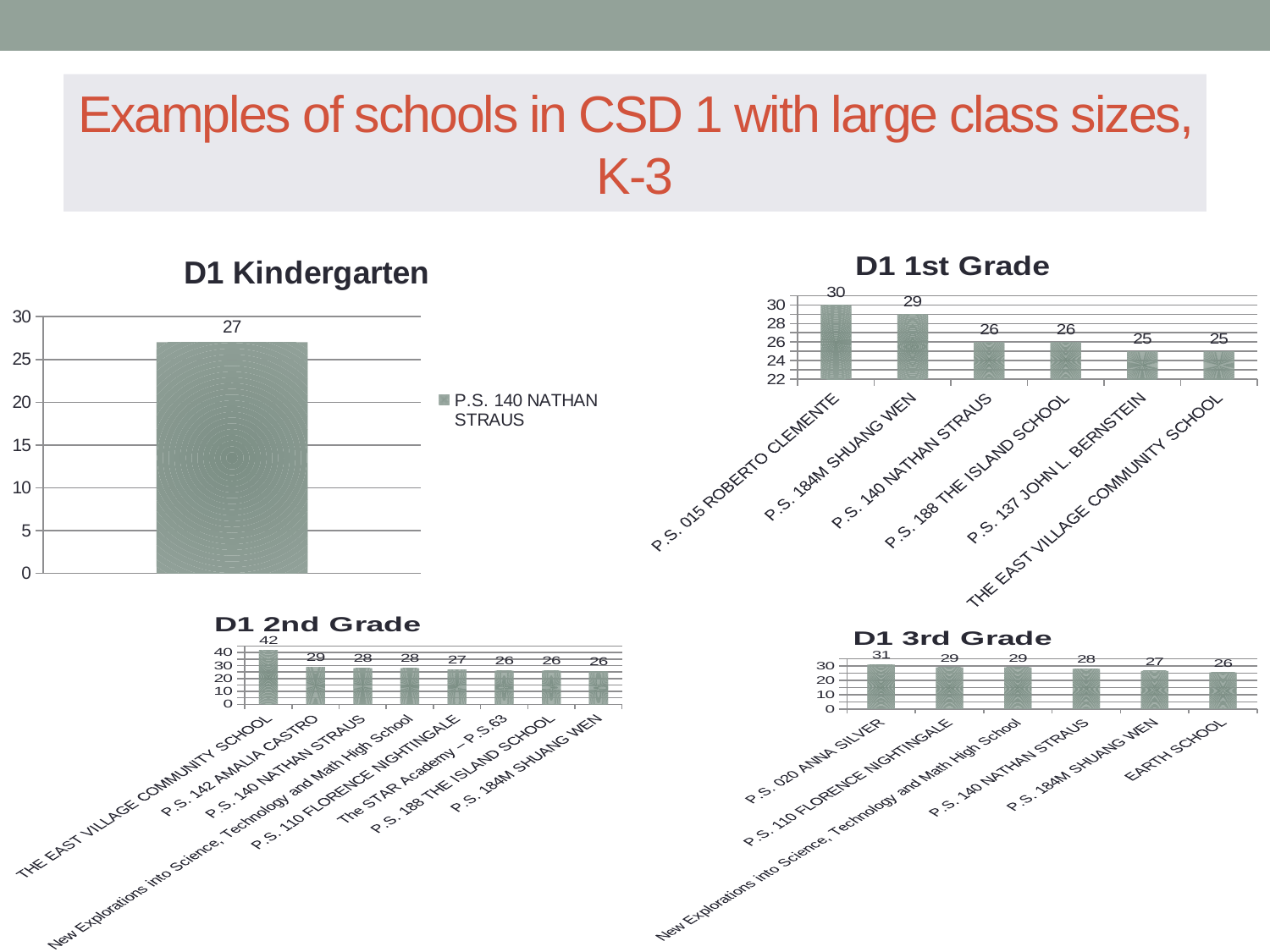
In the D1 Kindergarten chart, how many series does the legend list? 1 In the D1 1st Grade chart, which school has the highest value? P.S. 015 ROBERTO CLEMENTE In the D1 1st Grade chart, what is the value for P.S. 184M SHUANG WEN? 29 In the D1 3rd Grade chart, what is the value for P.S. 020 ANNA SILVER? 31 What kind of chart is the D1 1st Grade chart? Bar chart In the D1 3rd Grade chart, which school has the lowest value? EARTH SCHOOL In the D1 Kindergarten chart, what is the value for P.S. 140 NATHAN STRAUS? 27 In the D1 2nd Grade chart, what is the difference between THE EAST VILLAGE COMMUNITY SCHOOL and P.S. 142 AMALIA CASTRO? 13 In the D1 2nd Grade chart, how many schools are plotted? 8 In the D1 1st Grade chart, how many schools are plotted? 6 In the D1 3rd Grade chart, which is larger, the value for P.S. 140 NATHAN STRAUS or the value for P.S. 184M SHUANG WEN? P.S. 140 NATHAN STRAUS In the D1 2nd Grade chart, which school has the highest value? THE EAST VILLAGE COMMUNITY SCHOOL